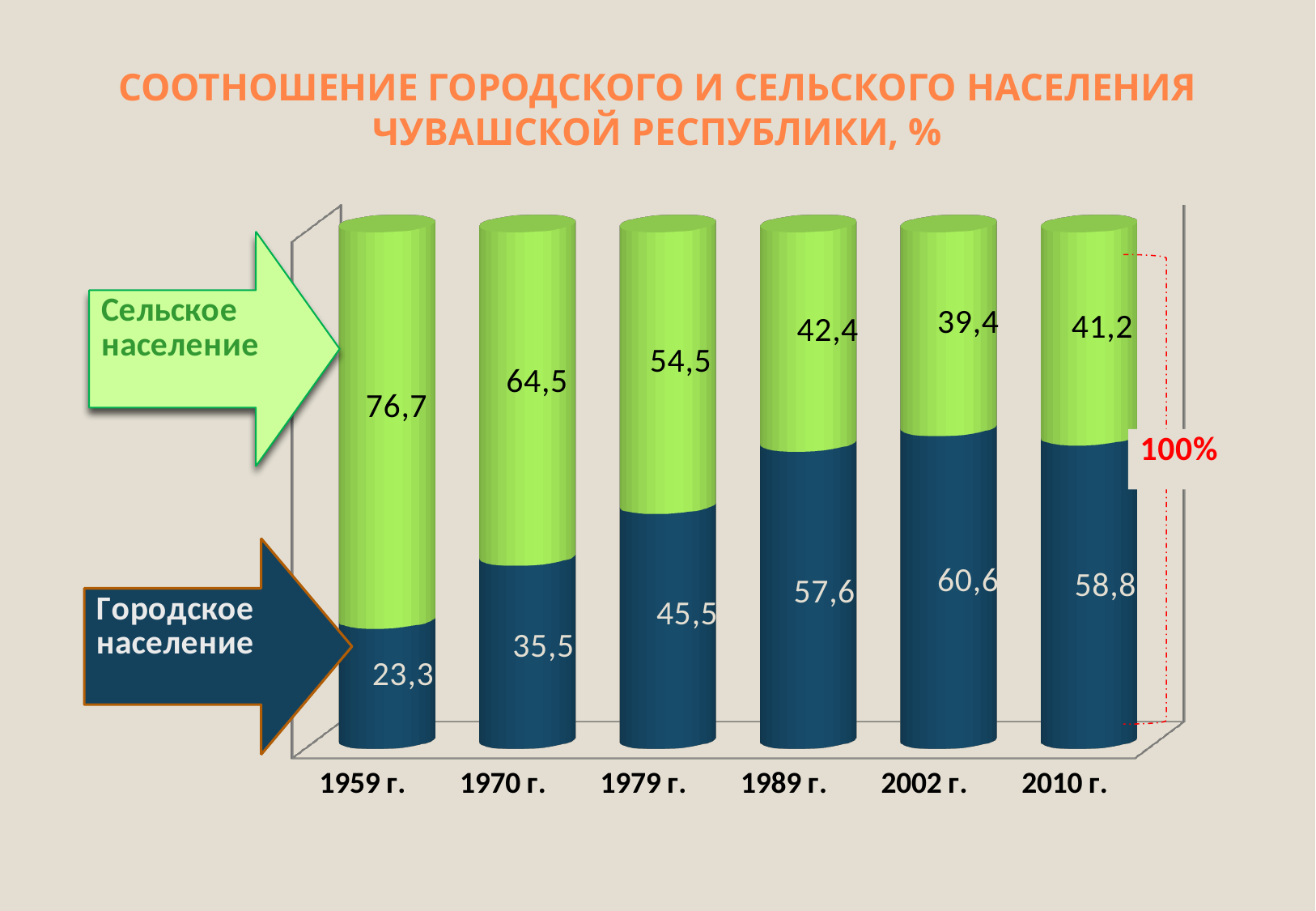
Which is larger in 2010 г.: the urban population share or the rural population share? Urban population share (58,8) What is the rural population share (Сельское население) in 2002 г.? 39,4 In which year is the urban population share (Городское население) the highest? 2002 г. How many years are shown on the x axis of the chart? 6 What is the difference between the rural and urban population shares in 1970 г.? 29 Does the rural population share (Сельское население) rise or fall from 1959 г. to 1989 г.? Fall Which colour represents the urban population (Городское население) in the chart? Dark blue What is the urban population share (Городское население) in 1959 г.? 23,3 How many series does the chart show? 2 What is the rural population share (Сельское население) in 1979 г.? 54,5 What kind of chart is shown on the slide? Stacked bar chart In which year is the rural population share (Сельское население) the lowest? 2002 г.